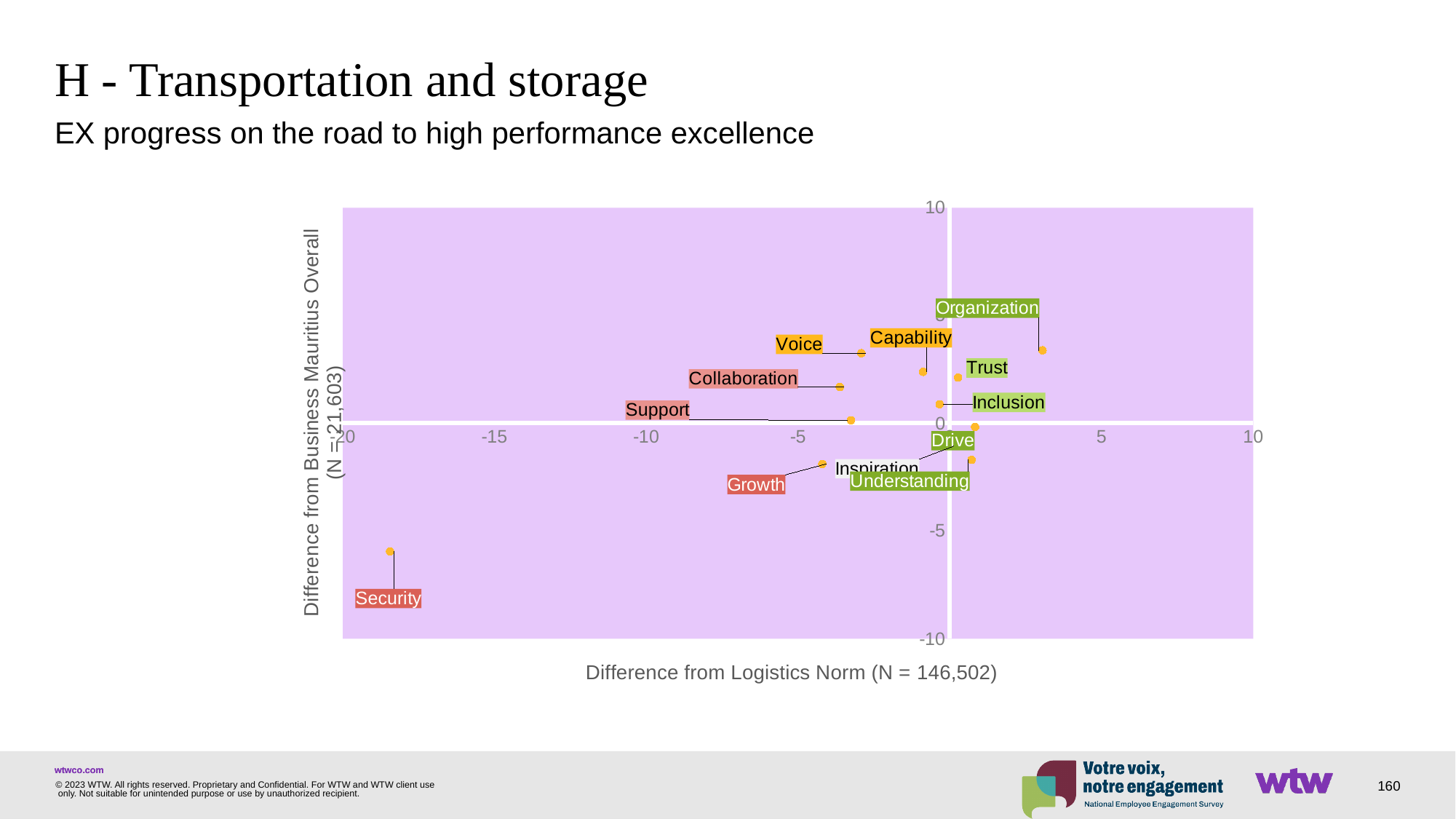
Is the vertical-axis value for Security greater or less than -5? less Which labelled point has the highest value on the horizontal axis (Difference from Logistics Norm)? Organization What kind of chart is shown on the slide? scatter chart Which has the larger vertical-axis value, Support or Security? Support Is the horizontal-axis value for Security greater or less than -15? less Which labelled point has the lowest value on the vertical axis (Difference from Business Mauritius Overall)? Security Is the horizontal-axis value for Organization greater or less than 5? less How many labelled data points are plotted on the chart? 12 Which labelled point has the lowest value on the horizontal axis (Difference from Logistics Norm)? Security What is the title of the horizontal axis? Difference from Logistics Norm (N = 146,502) What is the title of the vertical axis? Difference from Business Mauritius Overall (N = 21,603)